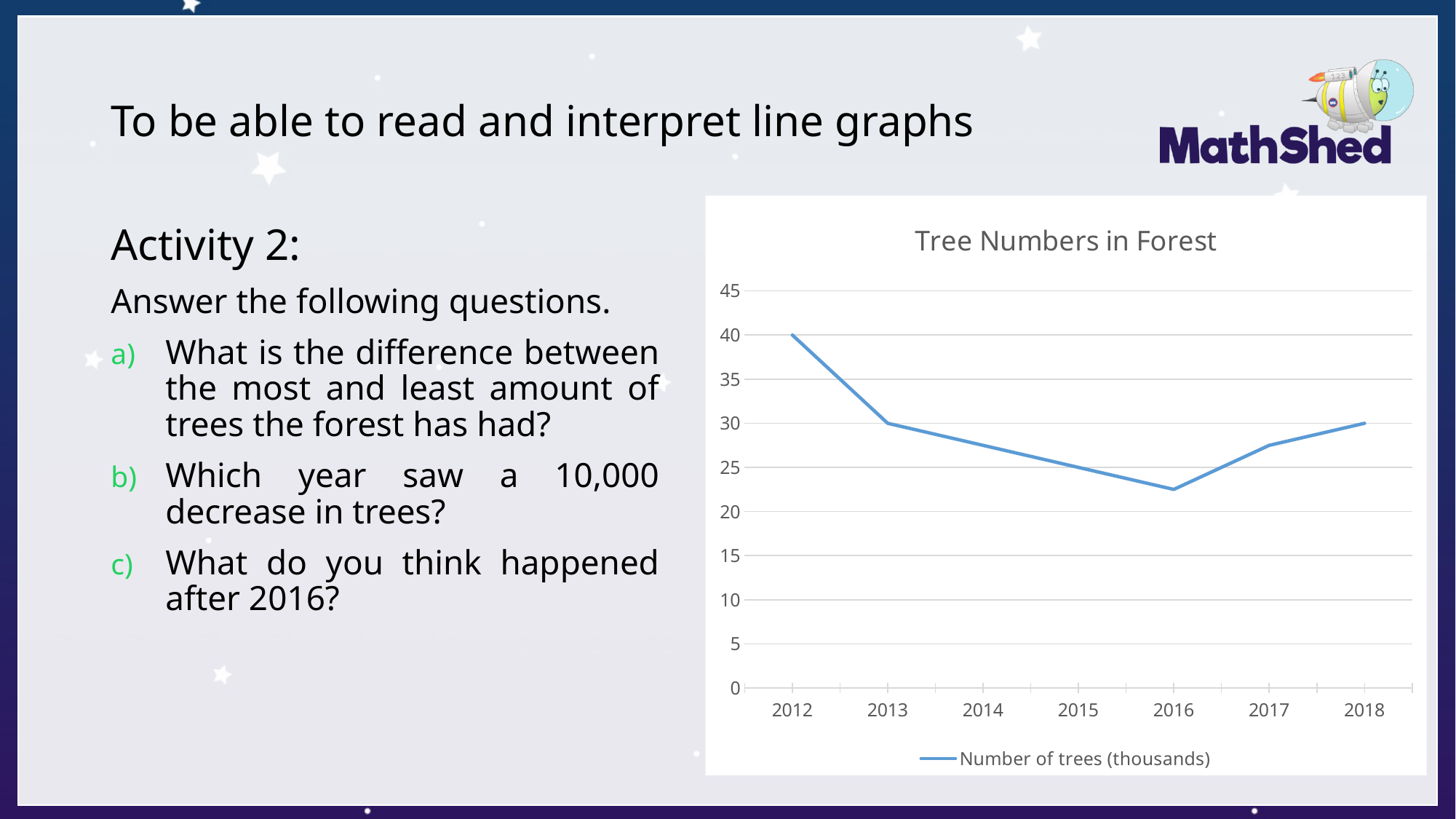
Which year has the lowest number of trees? 2016 What is the difference in number of trees (thousands) between 2012 and 2013? 10 Is the value for 2016 greater or less than 25? less What is the number of trees (thousands) in 2013? 30 How many years are plotted on the x axis? 7 What is the legend entry for the plotted series? Number of trees (thousands) What is the number of trees (thousands) in 2012? 40 How many series does the legend list? 1 What is the title of the chart? Tree Numbers in Forest Which year has the highest number of trees? 2012 What type of chart is shown on the slide? Line chart What is the number of trees (thousands) in 2018? 30